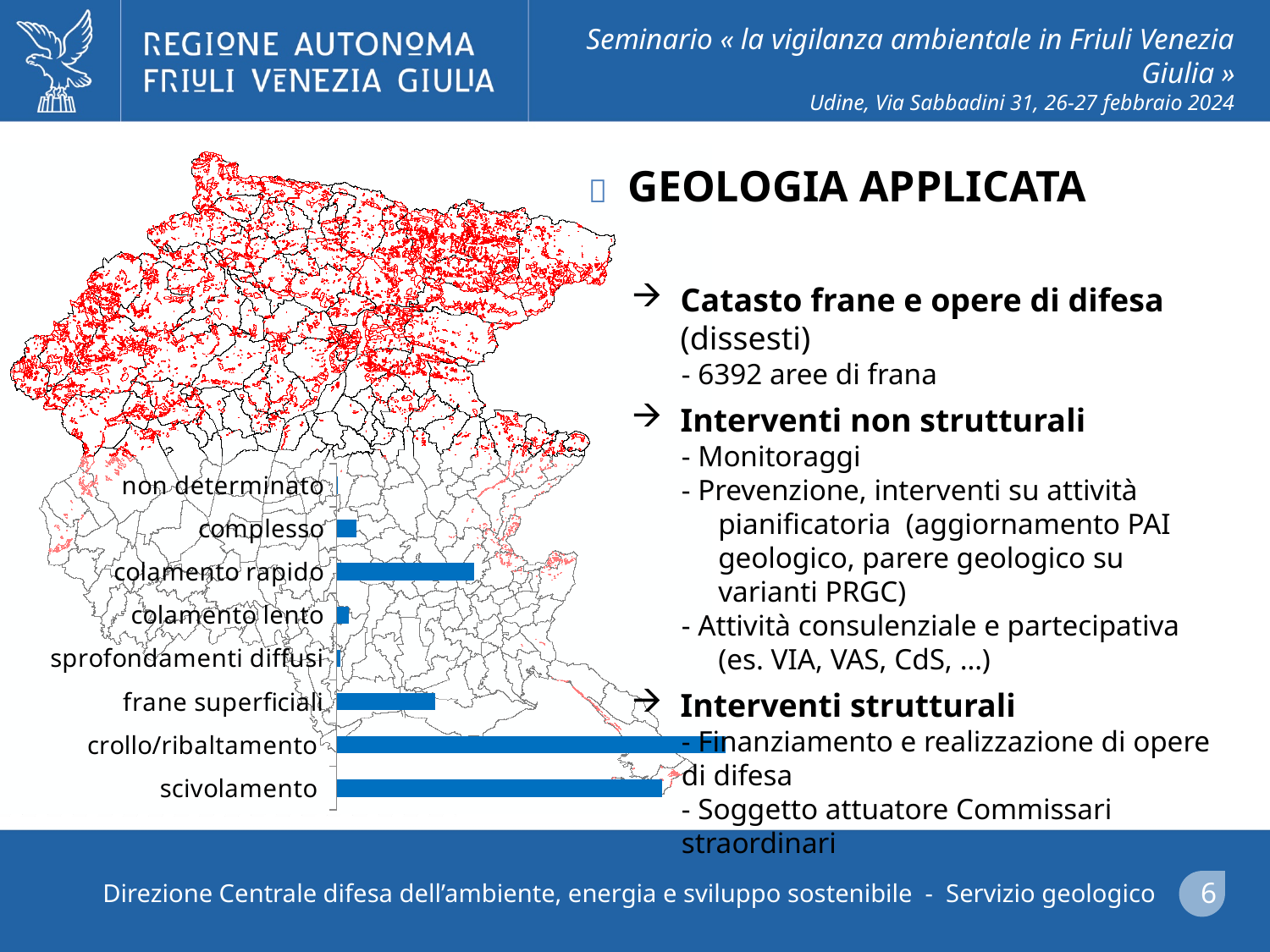
Which bar is longer, frane superficiali or sprofondamenti diffusi? frane superficiali Which category has the longest bar in the chart? crollo/ribaltamento How many categories does the bar chart show? 8 Which bar is longer, colamento rapido or complesso? colamento rapido Which bar is longer, scivolamento or frane superficiali? scivolamento What kind of chart is shown on the slide? bar chart Which category is listed at the bottom of the bar chart? scivolamento What colour are the bars in the chart? blue